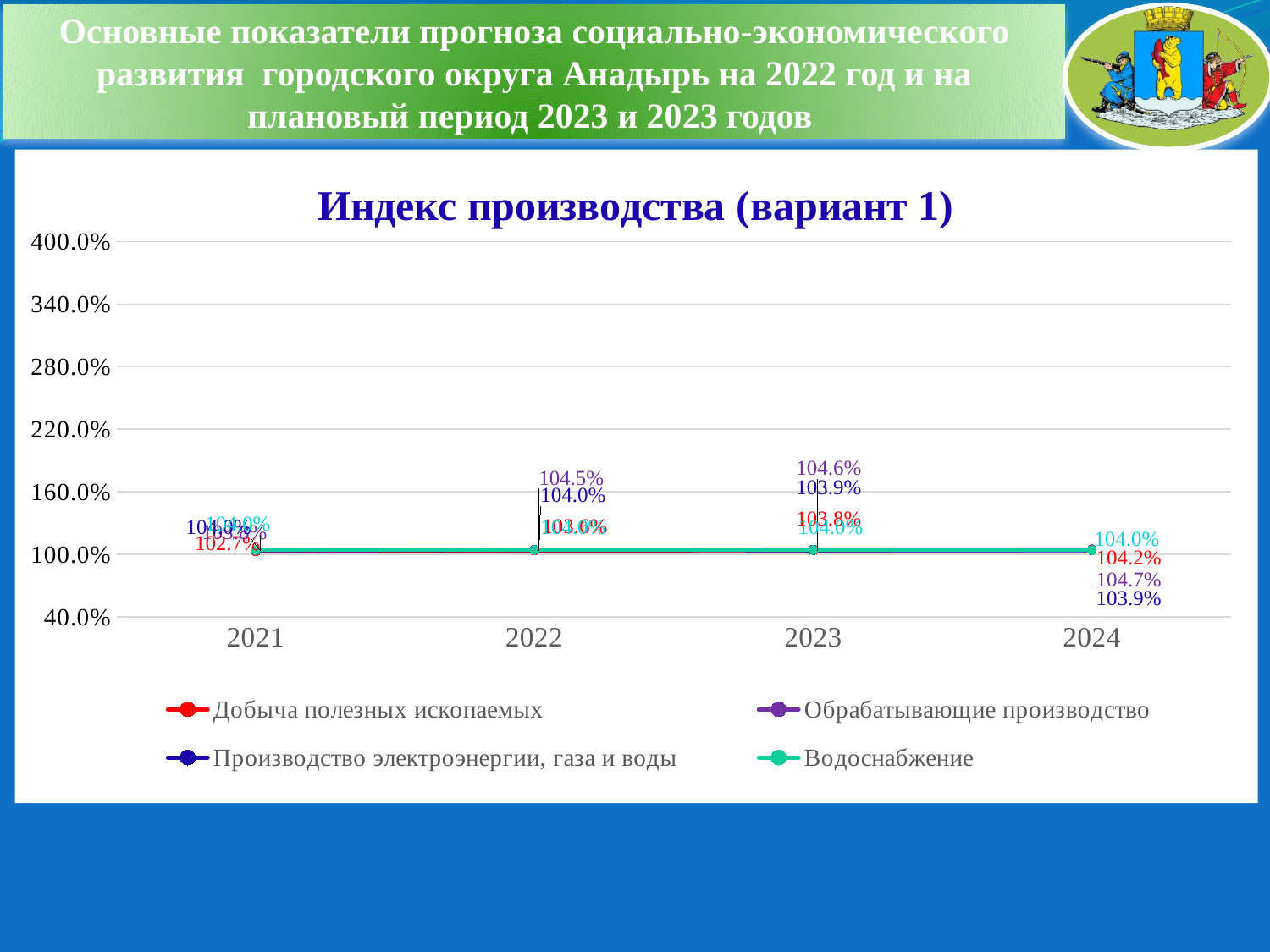
How many years are shown on the x axis? 4 What type of chart is shown on the slide? line chart Is the value for Обрабатывающие производство in 2023 greater or less than 160.0%? less What is the difference between the 2024 values for Обрабатывающие производство and Производство электроэнергии, газа и воды? 0.8% What is the value for Обрабатывающие производство in 2023? 104.6% What is the value for Водоснабжение in 2024? 104.0% What is the value for Обрабатывающие производство in 2024? 104.7% What is the value for Производство электроэнергии, газа и воды in 2024? 103.9% Which series has the highest value in 2024? Обрабатывающие производство How many series does the legend list? 4 What is the value for Добыча полезных ископаемых in 2024? 104.2% What is the title of the chart? Индекс производства (вариант 1)